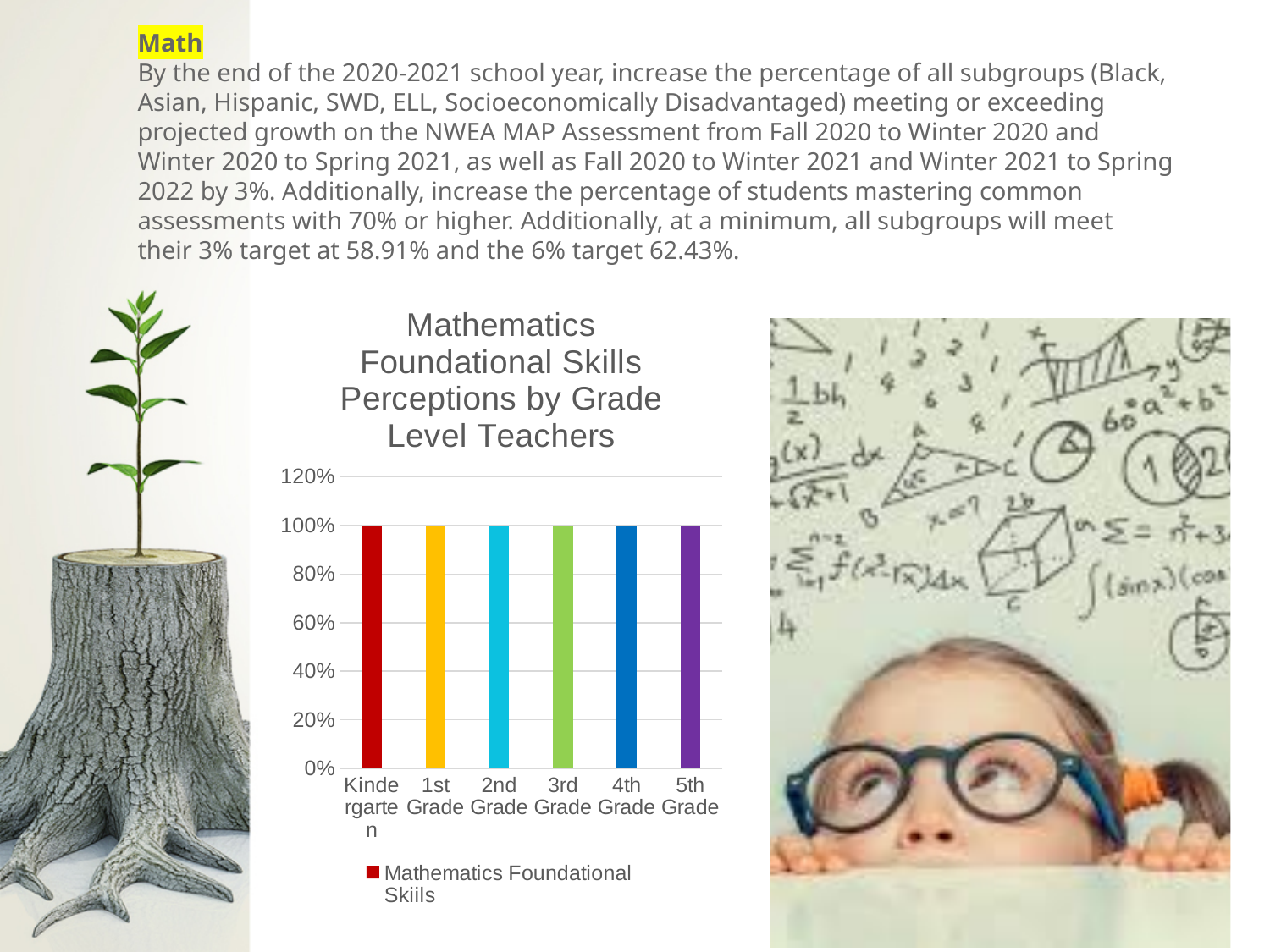
How many grade-level categories are shown on the x axis of the chart? 6 Is the value for 1st Grade greater or less than 80%? greater Is the value for 4th Grade greater or less than 120%? less What is the difference between the values for Kindergarten and 2nd Grade? 0% What series name appears in the chart's legend? Mathematics Foundational Skiils Do the values rise, fall, or stay flat from Kindergarten to 5th Grade? Stay flat What is the title of the chart? Mathematics Foundational Skills Perceptions by Grade Level Teachers What is the value for 5th Grade in the Mathematics Foundational Skills chart? 100% How many series does the chart's legend list? 1 What is the value for 3rd Grade in the Mathematics Foundational Skills chart? 100% What is the value for Kindergarten in the Mathematics Foundational Skills chart? 100% What type of chart is shown on the slide? Bar chart